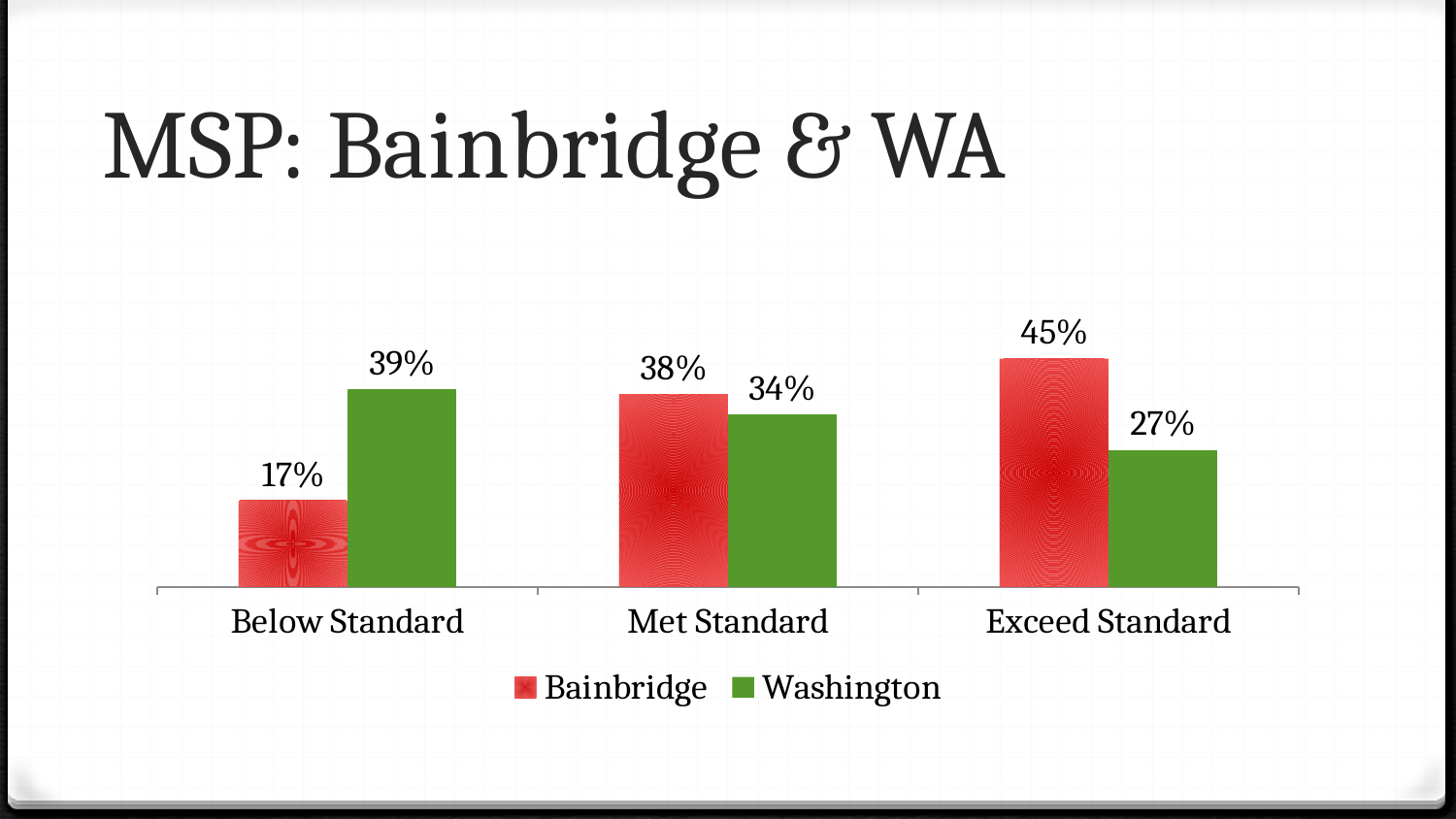
What is the difference between the Bainbridge and Washington values for Exceed Standard? 18% Do the Bainbridge values rise or fall from Below Standard to Exceed Standard? Rise What kind of chart is shown on the slide? Bar chart Which is larger for Met Standard, Bainbridge or Washington? Bainbridge How many categories are shown on the x axis? 3 What is the Washington value for Exceed Standard? 27% What is the Washington value for Met Standard? 34% Which category has the highest Bainbridge value? Exceed Standard What is the difference between the Washington and Bainbridge values for Below Standard? 22% How many series does the legend list? 2 What is the Bainbridge value for Below Standard? 17% Which category has the lowest Washington value? Exceed Standard